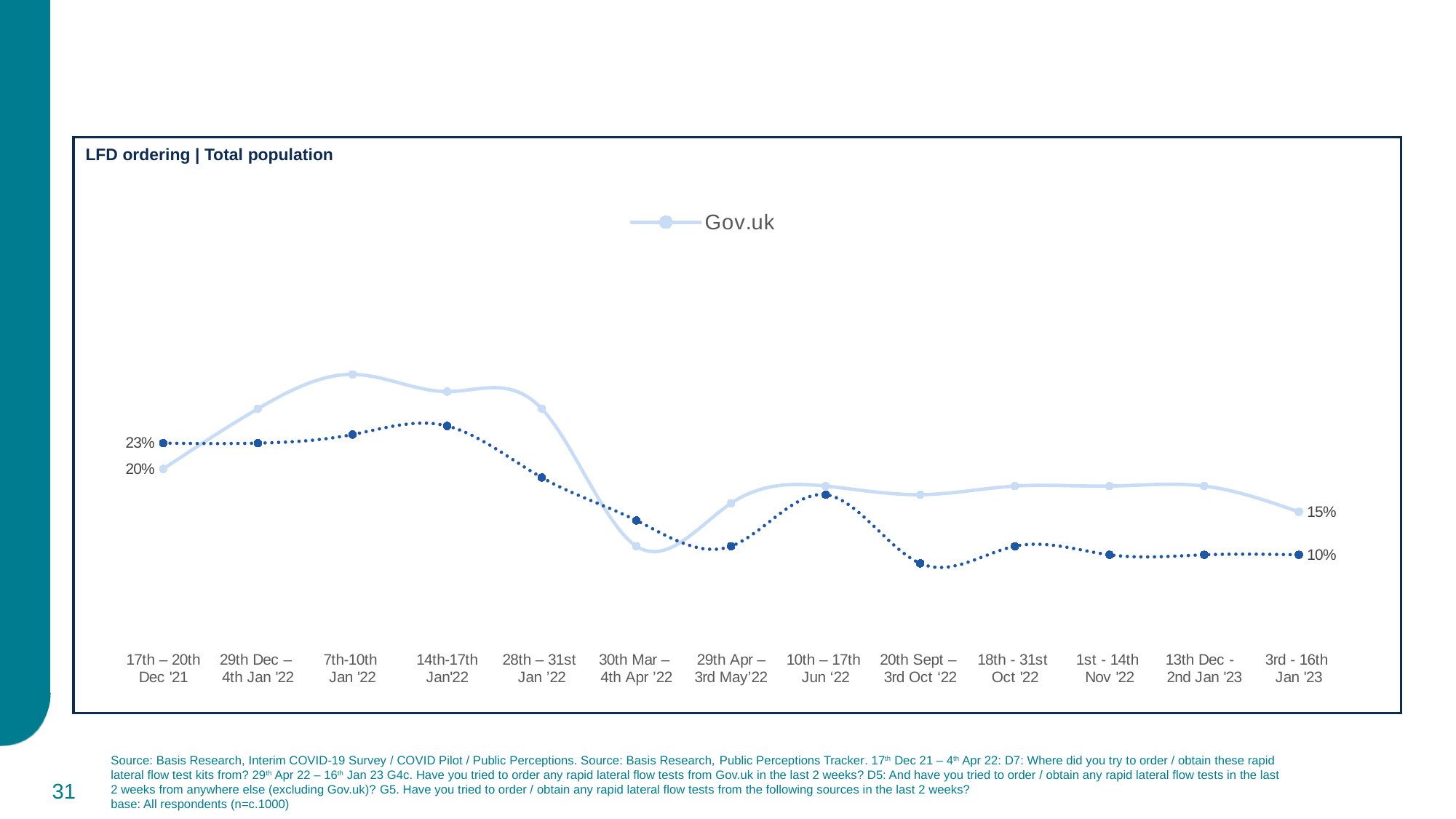
How many time periods are shown on the x axis? 13 What is the Gov.uk value for 3rd - 16th Jan '23? 15% In which period does the Gov.uk line reach its lowest point? 30th Mar – 4th Apr '22 What is the title of the chart? LFD ordering | Total population How many series does the chart legend list? 1 By how many percentage points is the Gov.uk value for 17th – 20th Dec '21 higher than for 3rd - 16th Jan '23? 5 percentage points What is the value of the dark blue dotted line at 3rd - 16th Jan '23? 10% What is the Gov.uk value for 17th – 20th Dec '21? 20% What type of chart is shown on the slide? Line chart In which period does the Gov.uk line reach its highest point? 7th-10th Jan '22 Which series is named in the chart legend? Gov.uk What is the value of the dark blue dotted line at 17th – 20th Dec '21? 23%